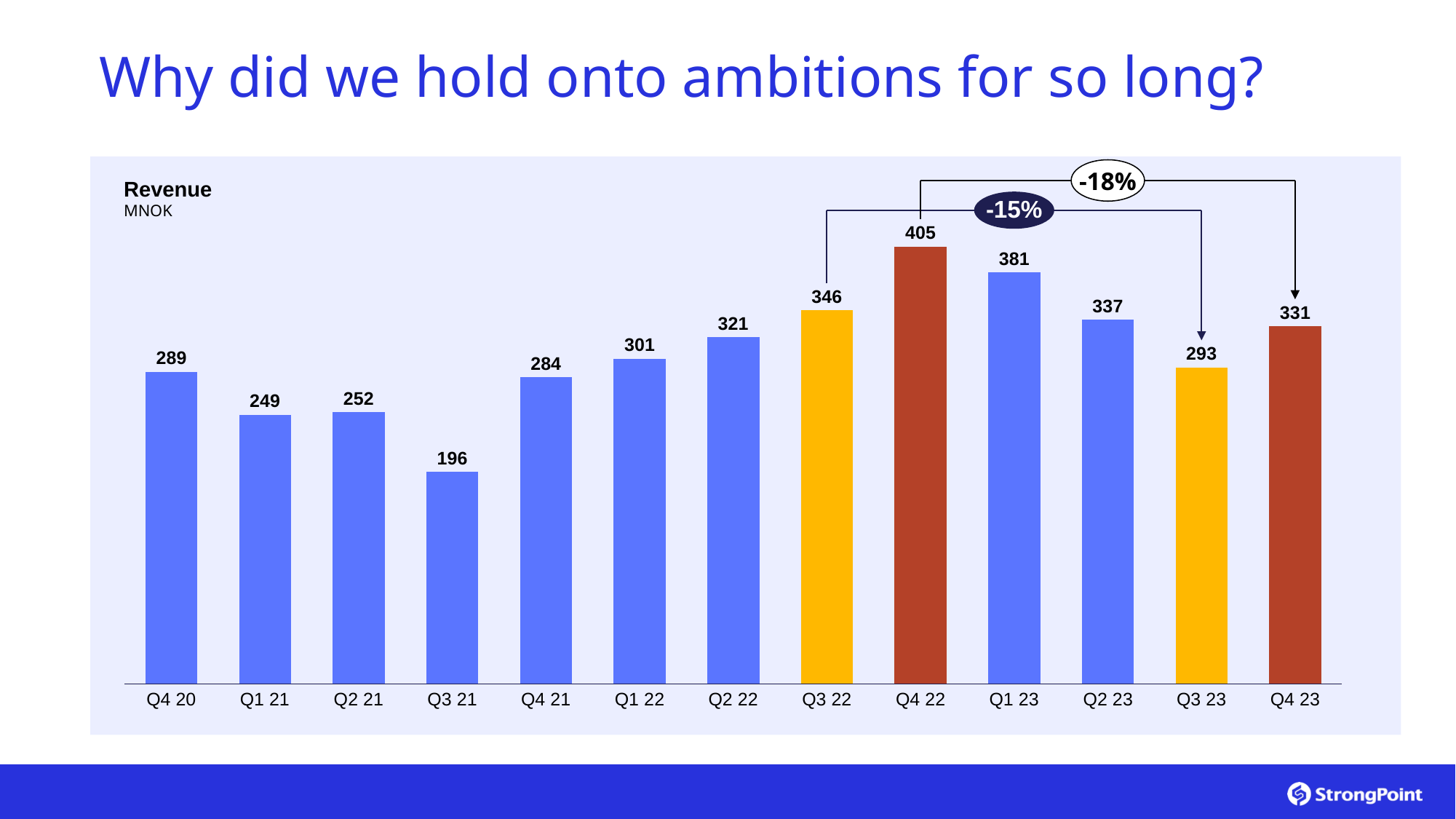
What percentage change is annotated between Q4 22 and Q4 23? -18% What unit is the revenue shown in? MNOK How many quarters are shown on the chart? 13 What kind of chart is shown on the slide? Bar chart What is the revenue for Q1 23? 381 What is the difference in revenue between Q4 22 and Q4 23? 74 Which is larger, the revenue for Q2 23 or the revenue for Q4 23? Q2 23 Which quarter has the lowest revenue? Q3 21 What is the revenue for Q3 21? 196 What is the difference in revenue between Q3 22 and Q3 23? 53 What is the revenue for Q4 22? 405 Which quarter has the highest revenue? Q4 22